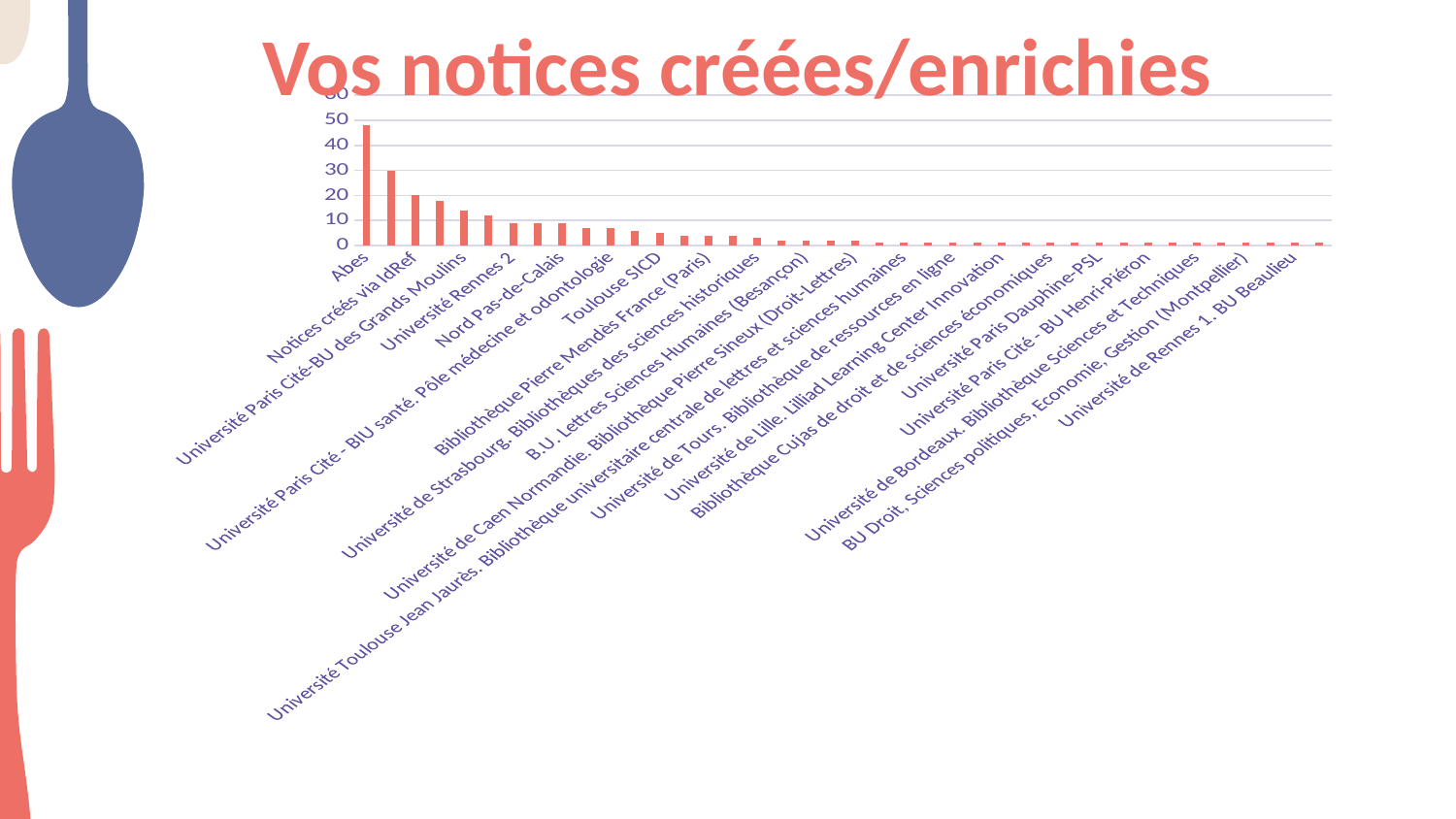
Does the chart display a legend? No Is the value for Université de Rennes 1. BU Beaulieu greater or less than 10? less Which has the larger value, Notices créés via IdRef or Université de Rennes 1. BU Beaulieu? Notices créés via IdRef What is the title of the chart? Vos notices créées/enrichies Which has the larger value, Abes or Université Rennes 2? Abes Which category has the highest value in the chart? Abes Is the value for Université Rennes 2 greater or less than 20? less What kind of chart is shown on the slide? bar chart Is the value for Abes greater or less than 40? greater Do the bar values rise or fall from left to right along the x axis? fall